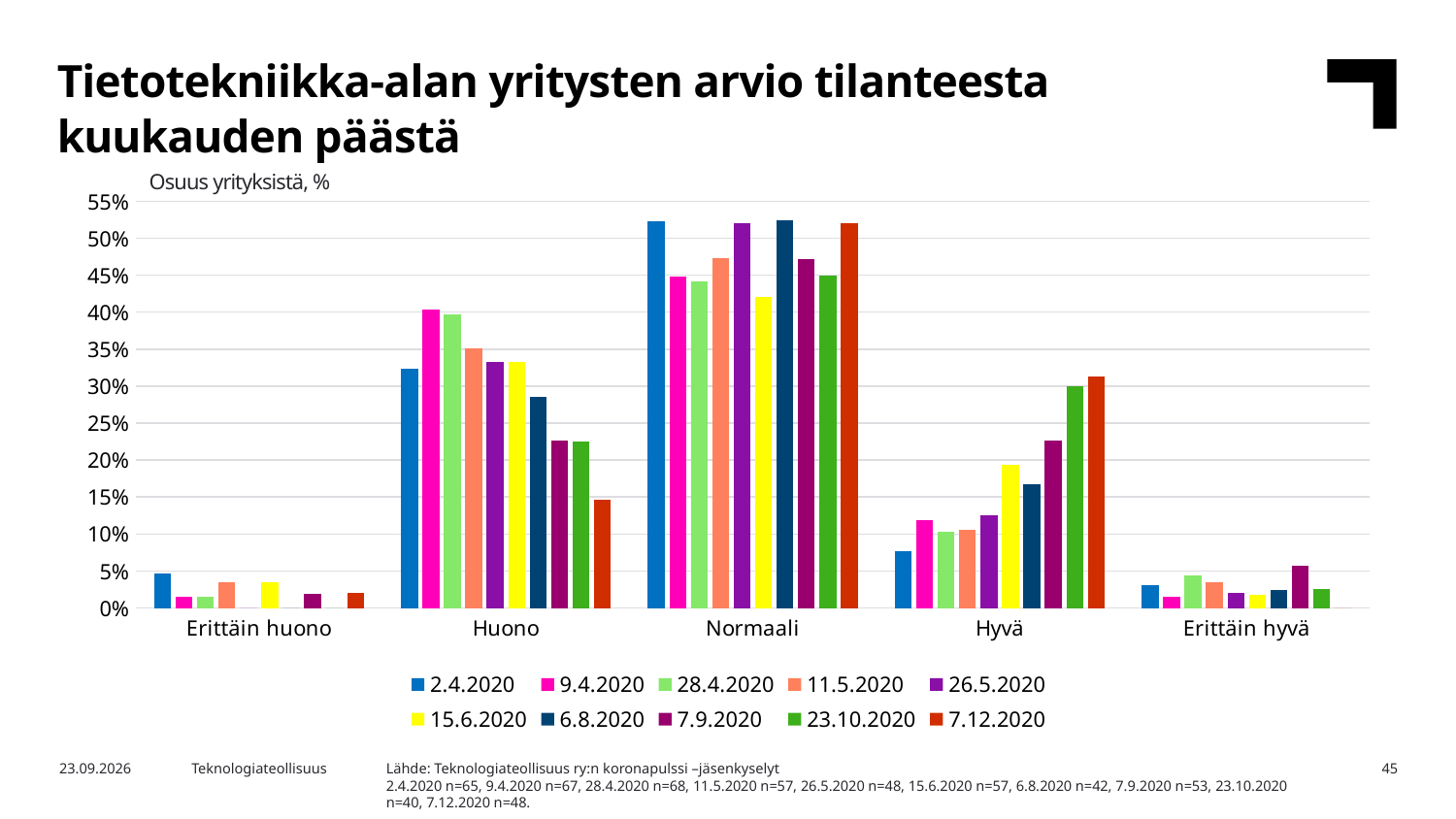
Is the value for 9.4.2020 in the Huono category greater or less than 35%? greater Is the value for 7.12.2020 in the Huono category greater or less than 20%? less In the Normaali category, which is larger: the value for 2.4.2020 or for 15.6.2020? 2.4.2020 What kind of chart is shown on the slide? Bar chart Is the value for 23.10.2020 in the Hyvä category greater or less than 25%? greater In the Hyvä category, do the values generally rise or fall from the earliest survey date (2.4.2020) to the latest (7.12.2020)? rise Within the Hyvä category, which survey date has the lowest value? 2.4.2020 How many series does the legend list? 10 How many categories are shown on the x axis of the chart? 5 For the 2.4.2020 series, which is larger: the value for Huono or for Hyvä? Huono What is the label shown above the y axis of the chart? Osuus yrityksistä, % Within the Huono category, which survey date has the lowest value? 7.12.2020